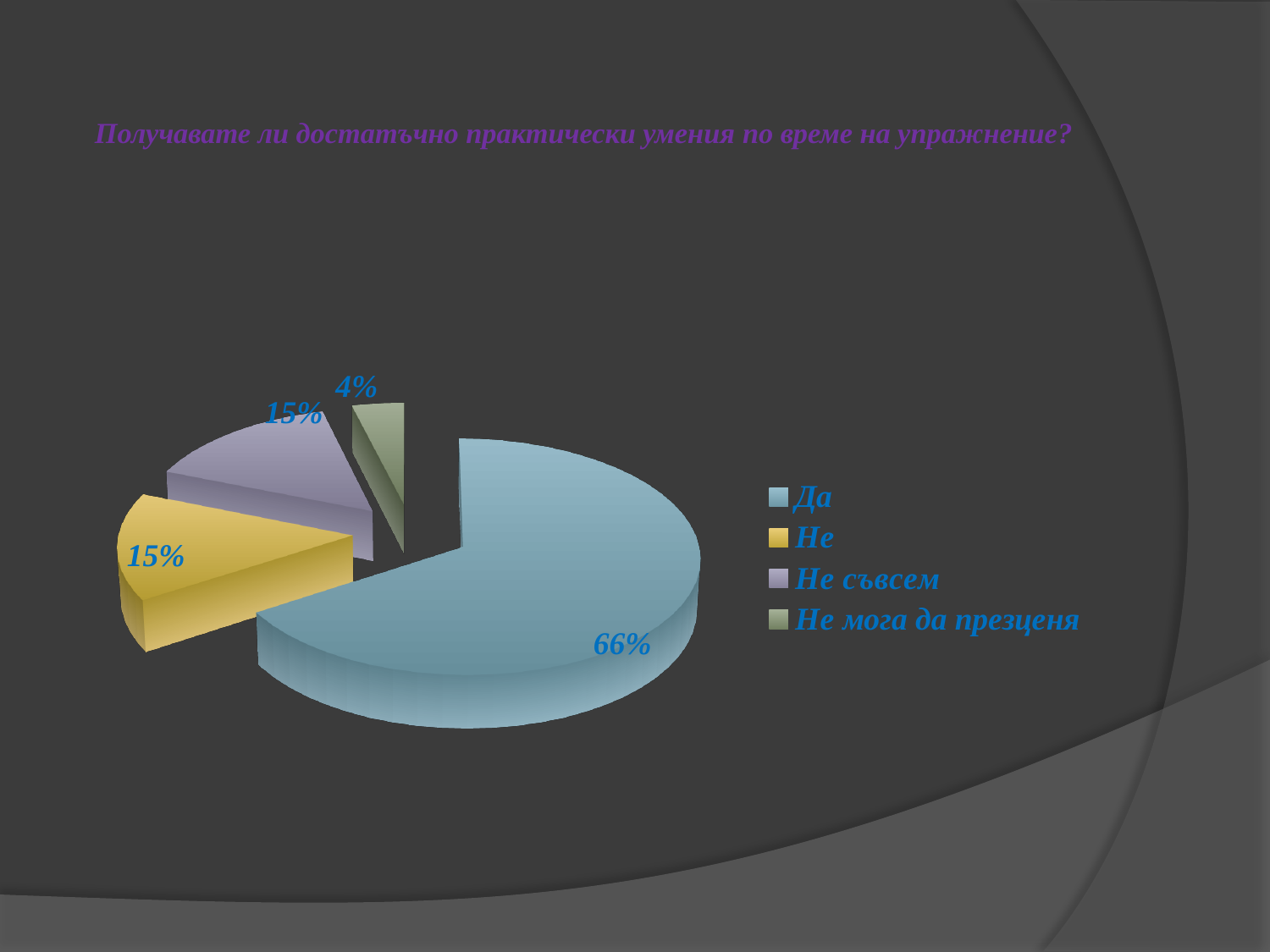
By how many percentage points does the "Да" share exceed the "Не" share? 51 percentage points Which is larger, the share for "Да" or the share for "Не"? Да Which category has the largest share of the pie? Да What percentage of the pie is the "Да" slice? 66% What percentage of the pie is the "Не" slice? 15% What percentage of the pie is the "Не съвсем" slice? 15% How many categories does the legend of the pie chart list? 4 What percentage of the pie is the "Не мога да презценя" slice? 4% What colour is the "Не" slice in the pie chart? Yellow What kind of chart is shown on the slide? Pie chart Which category has the smallest share of the pie? Не мога да презценя By how many percentage points does the "Не съвсем" share exceed the "Не мога да презценя" share? 11 percentage points